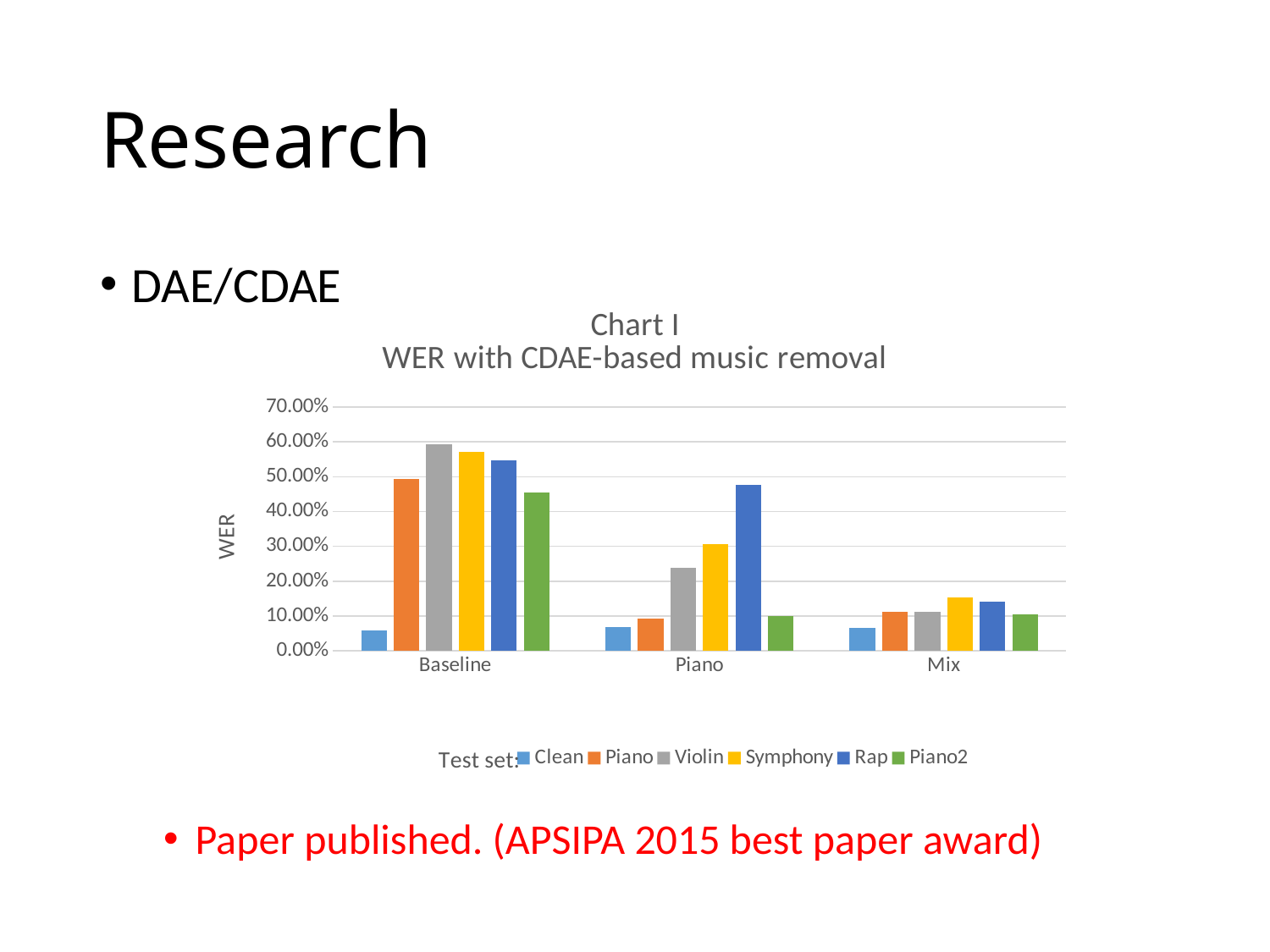
Is the WER for the Violin test set in the Baseline category greater or less than 50.00%? greater What kind of chart is shown on the slide? bar chart Is the WER for the Rap test set in the Piano category greater or less than 40.00%? greater Is the WER for the Symphony test set in the Piano category greater or less than 40.00%? less In the Piano category, which test set has the highest WER? Rap In the Baseline category, which test set has the lowest WER? Clean Which is larger: the WER for the Piano test set in the Baseline category or in the Piano category? Baseline How many categories are shown along the x axis of the chart? 3 What is the title of the chart below 'Chart I'? WER with CDAE-based music removal How many series does the legend of the chart list? 6 What is the label on the vertical axis of the chart? WER Does the WER for the Rap test set rise or fall going from Baseline to Piano to Mix? fall